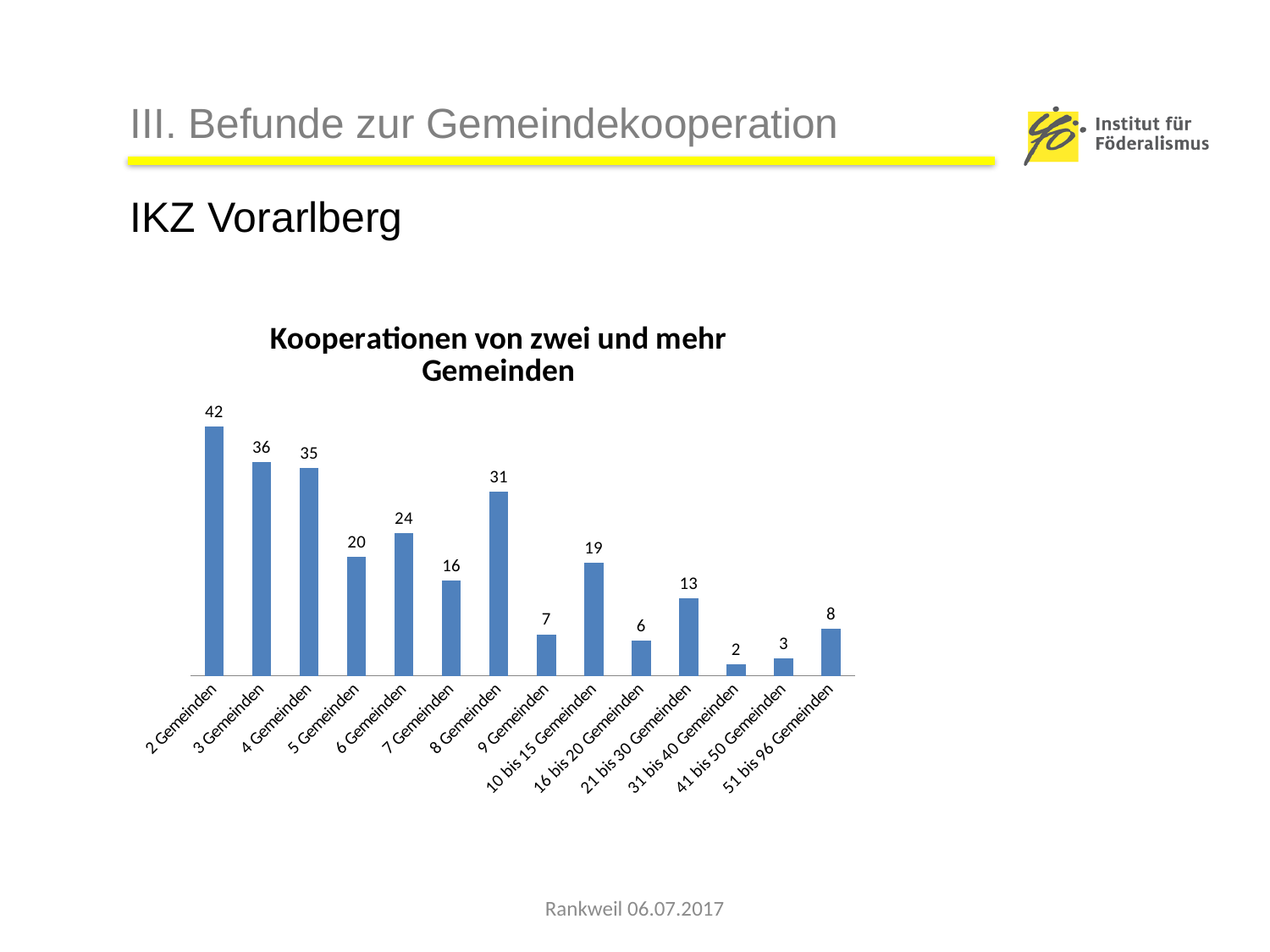
What is the value for 8 Gemeinden? 31 Which category has the highest value? 2 Gemeinden Which category has the lowest value? 31 bis 40 Gemeinden What is the difference between the values for 2 Gemeinden and 9 Gemeinden? 35 What is the title of the chart? Kooperationen von zwei und mehr Gemeinden What is the value for 16 bis 20 Gemeinden? 6 Which is larger, the value for 6 Gemeinden or the value for 7 Gemeinden? 6 Gemeinden What is the difference between the values for 3 Gemeinden and 5 Gemeinden? 16 How many categories are shown on the x axis? 14 What is the value for 2 Gemeinden? 42 What is the value for 51 bis 96 Gemeinden? 8 What kind of chart is shown? bar chart